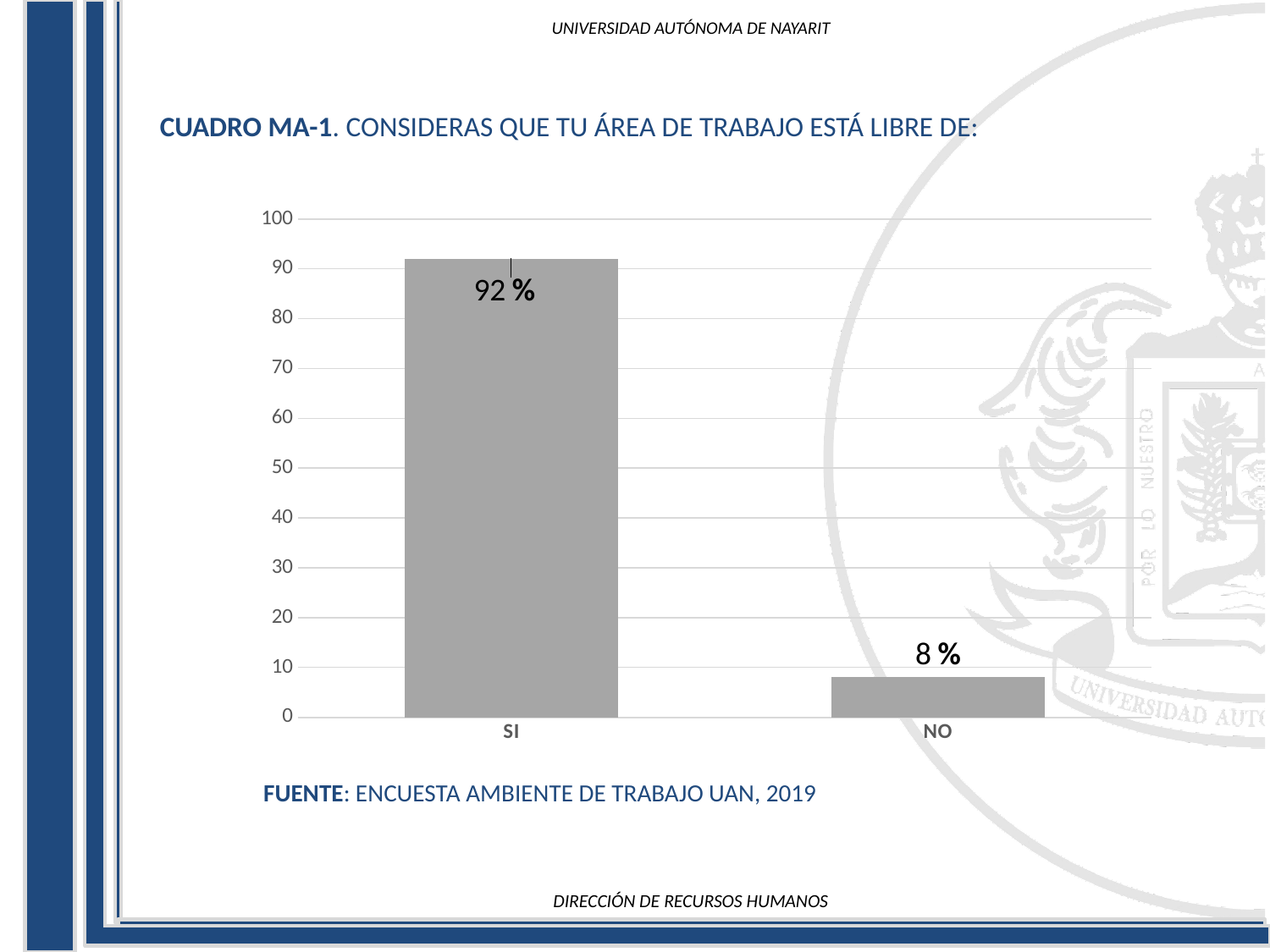
What is the difference between the values for SI and NO? 84 % Is the value for SI greater or less than 90? greater What is the title of the chart? CUADRO MA-1. CONSIDERAS QUE TU ÁREA DE TRABAJO ESTÁ LIBRE DE: Is the value for NO greater or less than 10? less How many categories are shown on the x axis? 2 What kind of chart is shown on the slide? bar chart What is the source cited below the chart? ENCUESTA AMBIENTE DE TRABAJO UAN, 2019 What is the value for NO? 8 % Which category has the lowest value? NO Which is larger, the value for SI or the value for NO? SI Which category has the highest value? SI What is the value for SI? 92 %